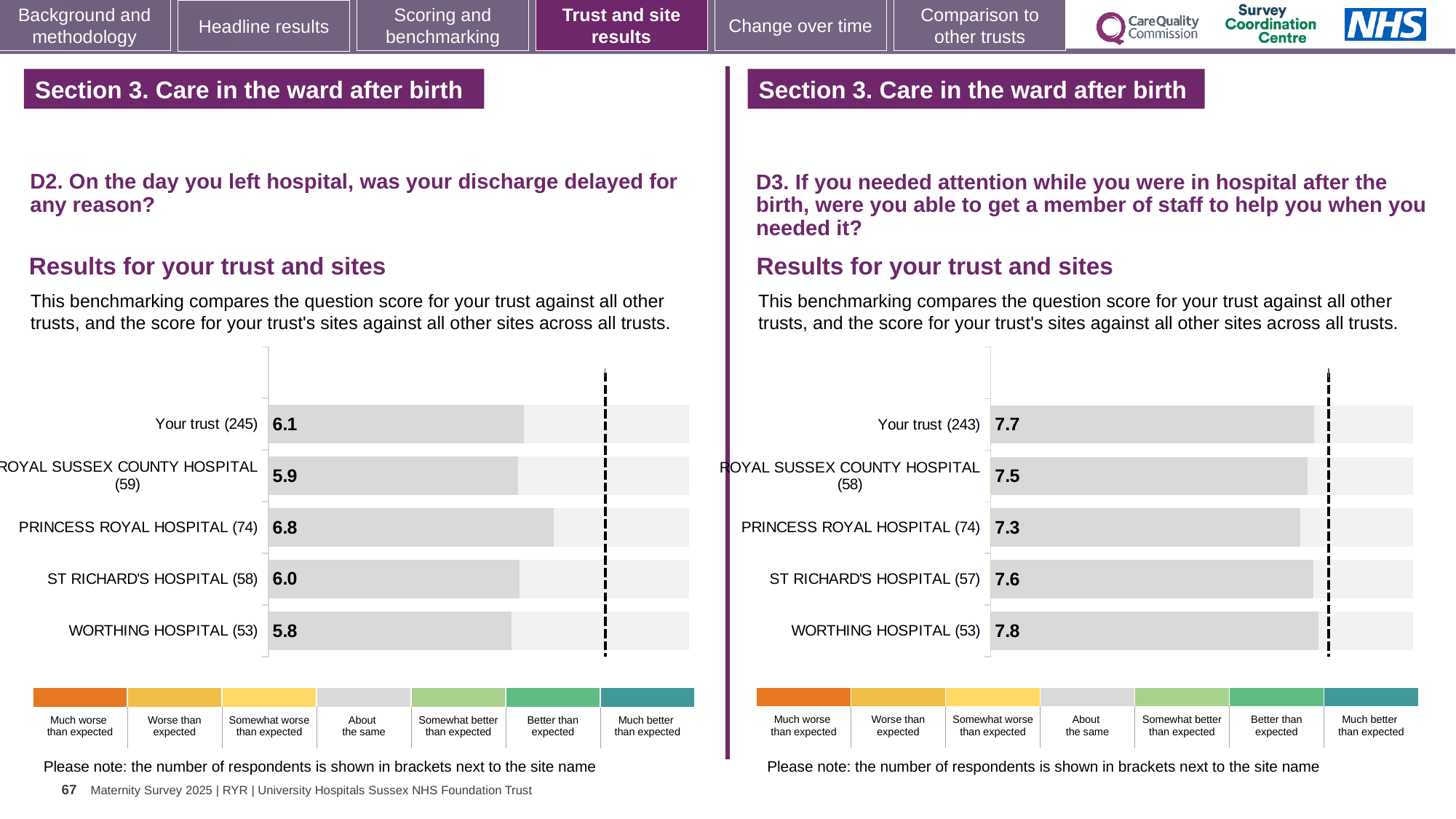
In the D2 chart on the left, what is the score for Princess Royal Hospital? 6.8 In the D2 chart on the left, what is the score for Your trust? 6.1 In the D2 chart on the left, which site has the highest score? Princess Royal Hospital In the D2 chart on the left, which site has the lowest score? Worthing Hospital In the D3 chart on the right, which site has the lowest score? Princess Royal Hospital In the D3 chart on the right, what is the difference between the scores for Your trust and Princess Royal Hospital? 0.4 In the D3 chart on the right, which is larger: the score for Your trust or the score for Royal Sussex County Hospital? Your trust What kind of chart is used in the D3 chart on the right? Bar chart In the D3 chart on the right, what is the score for Worthing Hospital? 7.8 In the D2 chart on the left, how many bars are plotted? 5 In the D2 chart on the left, what is the difference between the scores for Princess Royal Hospital and Worthing Hospital? 1.0 In the D3 chart on the right, what is the score for St Richard's Hospital? 7.6